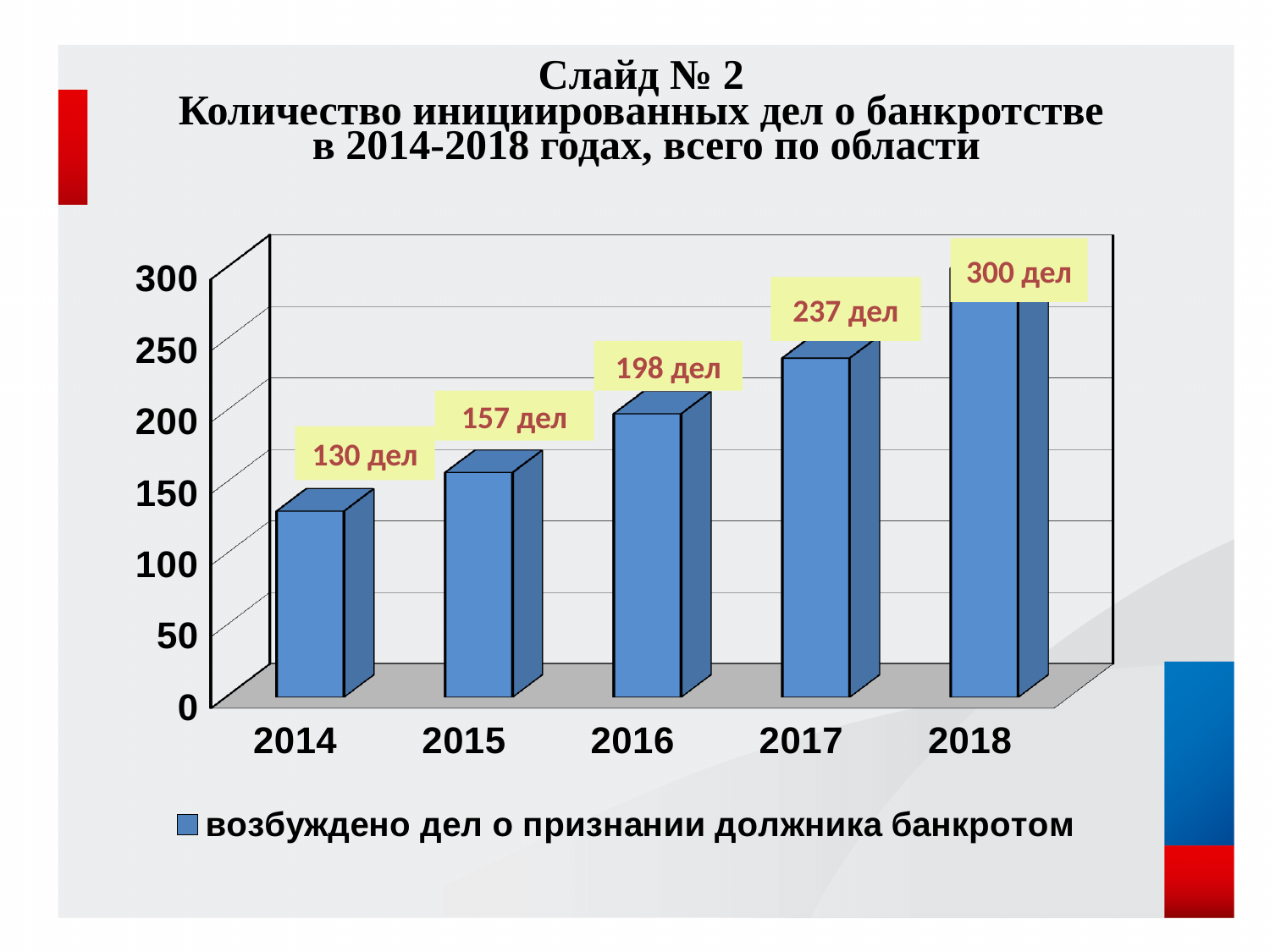
Which year has the highest value? 2018 What is the value for 2018? 300 дел Do the values rise or fall from 2014 to 2018? rise Is the value for 2017 greater or less than 200? greater What is the difference between the values for 2018 and 2014? 170 Which year has the lowest value? 2014 What is the value for 2016? 198 дел Which is larger, the value for 2015 or the value for 2017? 2017 What is the difference between the values for 2017 and 2016? 39 How many years are shown on the x axis? 5 What kind of chart is shown on the slide? bar chart What is the value for 2014? 130 дел